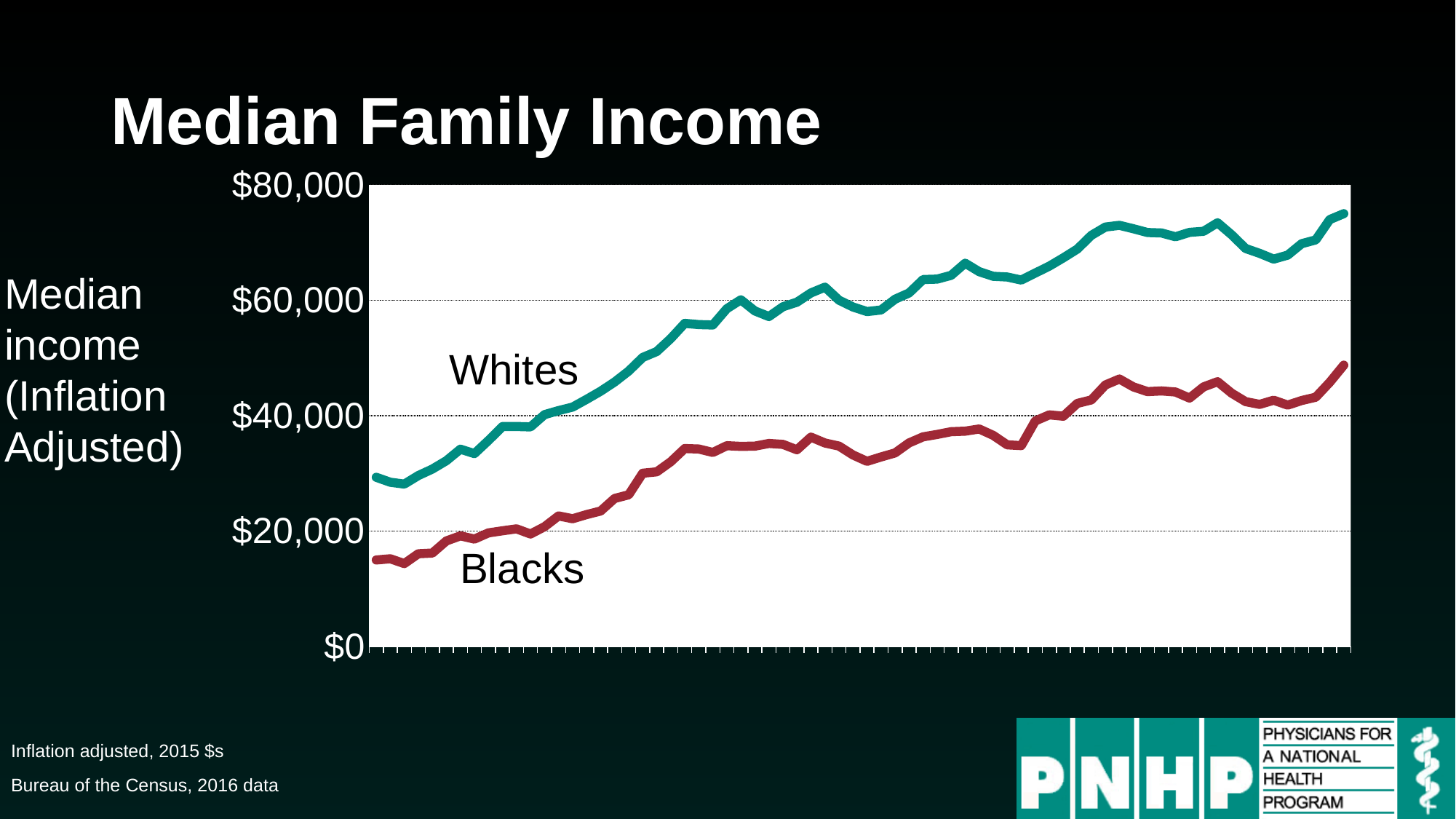
Overall, do the values for Blacks rise or fall from left to right along the x axis? rise Is the value for Whites at the right end of the chart greater or less than $60,000? greater What kind of chart is shown on the slide? line chart Overall, do the values for Whites rise or fall from left to right along the x axis? rise Is the value for Blacks at the left end of the chart greater or less than $20,000? less Is the value for Whites at the left end of the chart greater or less than $20,000? greater Which two groups are plotted on the chart? Whites and Blacks Which series has the higher median income across the whole chart, Whites or Blacks? Whites How many data series are plotted on the chart? 2 What is the title of the chart? Median Family Income